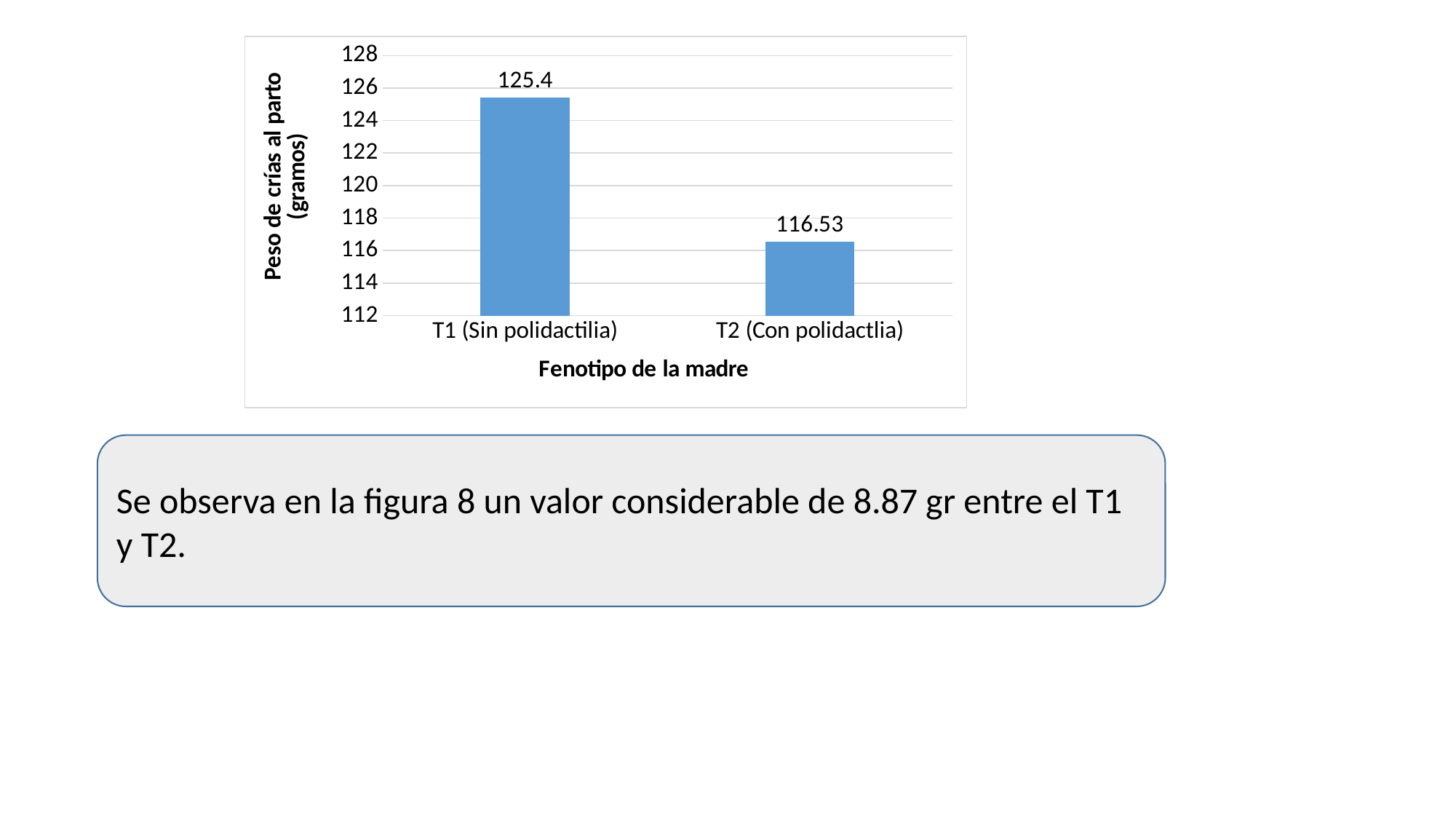
What is the value for T1 (Sin polidactilia)? 125.4 Is the value for T1 (Sin polidactilia) greater or less than 124? greater How many categories are shown on the x axis? 2 What kind of chart is shown on the slide? bar chart What is the difference between the values for T1 (Sin polidactilia) and T2 (Con polidactlia)? 8.87 What is the label of the y axis? Peso de crías al parto (gramos) Is the value for T2 (Con polidactlia) greater or less than 120? less What is the label of the x axis? Fenotipo de la madre What is the value for T2 (Con polidactlia)? 116.53 Which category has the highest value? T1 (Sin polidactilia) Which category has the lowest value? T2 (Con polidactlia) Which is larger, the value for T1 (Sin polidactilia) or T2 (Con polidactlia)? T1 (Sin polidactilia)